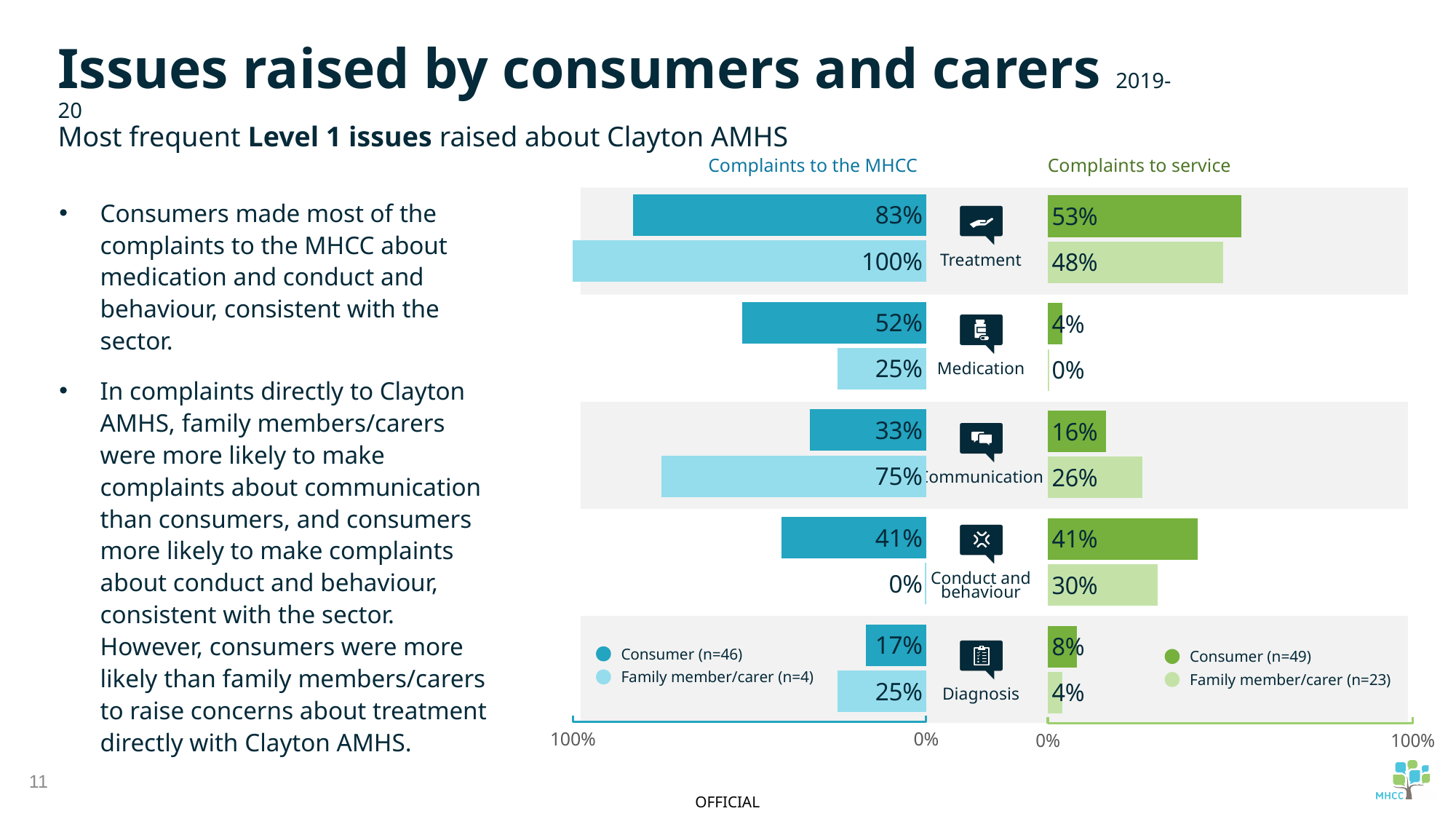
In the 'Complaints to the MHCC' chart, what is the family member/carer value for Conduct and behaviour? 0% How many series does the legend of the 'Complaints to the MHCC' chart list? 2 In the 'Complaints to the MHCC' chart, what percentage of consumer complaints were about Treatment? 83% In the 'Complaints to service' chart, what percentage of family member/carer complaints were about Communication? 26% In the 'Complaints to the MHCC' chart, which is larger for Medication: the consumer value or the family member/carer value? Consumer In the 'Complaints to service' chart, which issue has the highest consumer percentage? Treatment In the 'Complaints to the MHCC' chart, what is the difference between the family member/carer and consumer percentages for Communication? 42% According to the legend of the 'Complaints to service' chart, how many family members/carers are in the sample? n=23 What type of chart is the 'Complaints to service' chart? Bar chart In the 'Complaints to service' chart, what is the difference between the consumer and family member/carer percentages for Conduct and behaviour? 11% In the 'Complaints to the MHCC' chart, which issue has the lowest consumer percentage? Diagnosis How many issue categories are shown in the 'Complaints to service' chart? 5